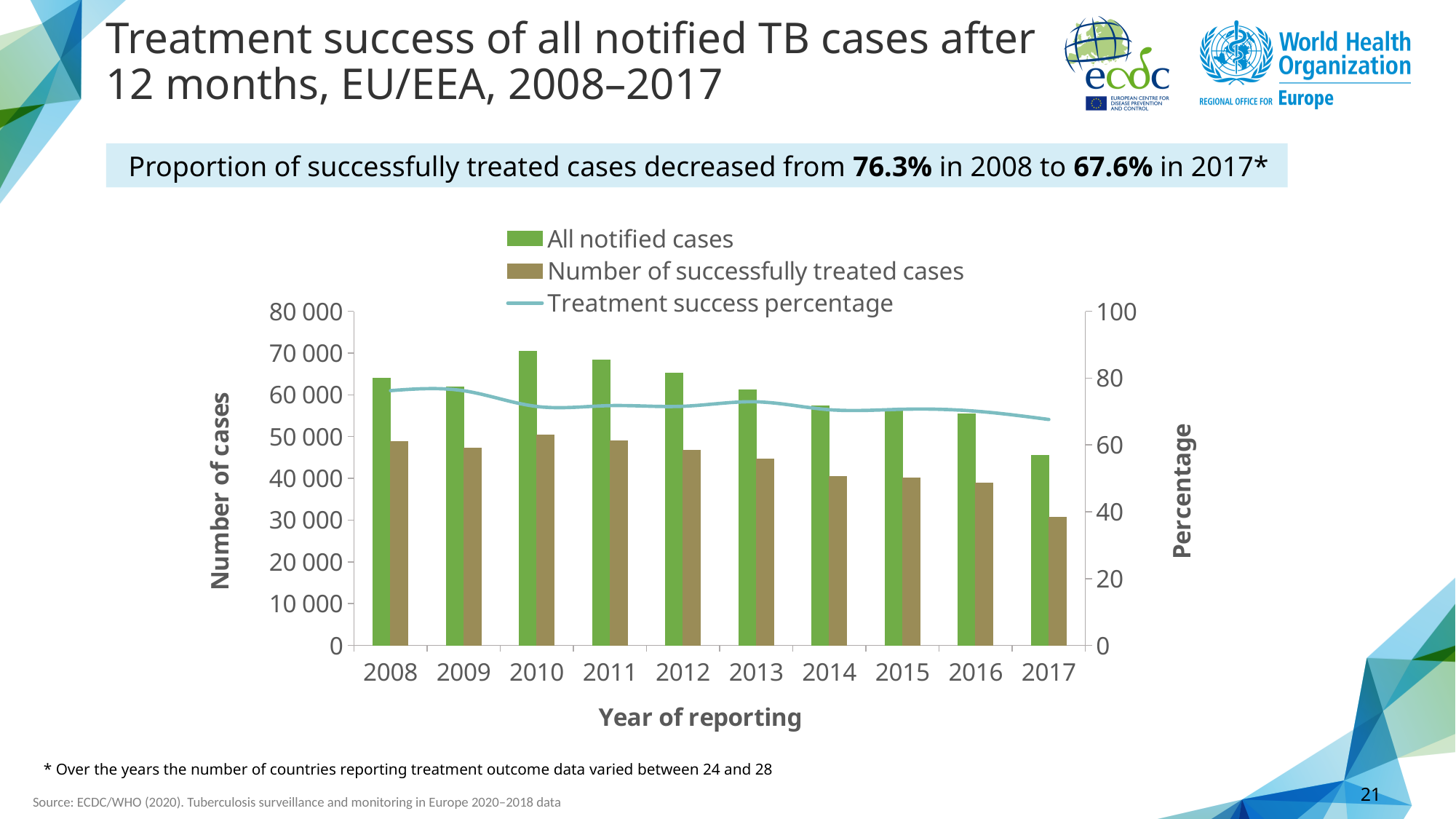
By how many percentage points did the treatment success percentage decrease from 2008 to 2017? 8.7 percentage points In which year is the number of all notified cases lowest? 2017 Does the treatment success percentage rise or fall from 2008 to 2017? fall In which year is the number of all notified cases highest? 2010 What kind of chart is shown on the slide? bar chart with a line In which year is the number of successfully treated cases lowest? 2017 Is the number of all notified cases in 2017 greater or less than 50 000? less What was the treatment success percentage in 2017? 67.6% What was the treatment success percentage in 2008? 76.3% Is the number of successfully treated cases in 2017 greater or less than 40 000? less How many series does the legend list? 3 How many years are shown on the x axis? 10